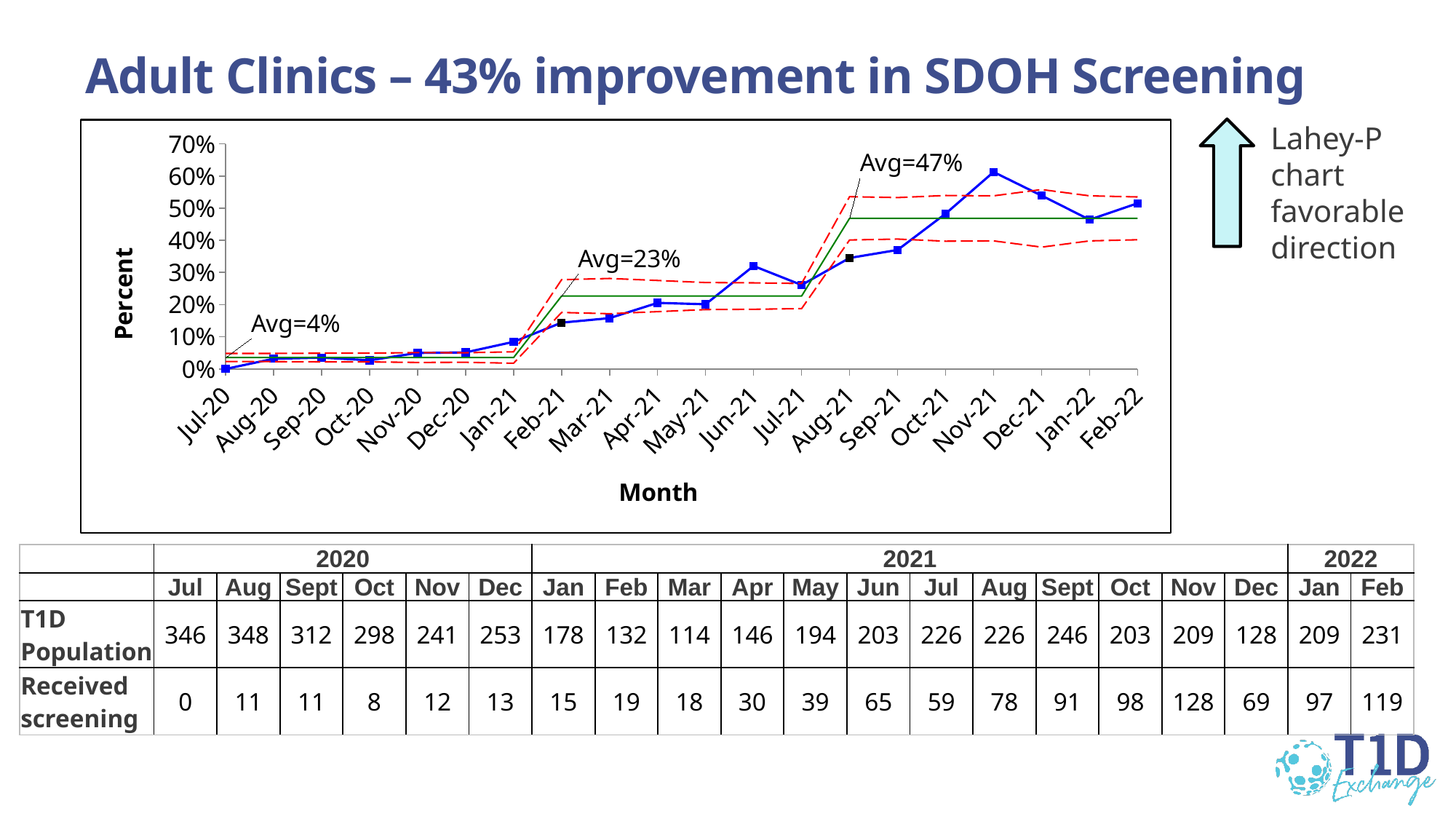
Is the value for Nov-21 greater or less than 60%? greater What is the average percentage shown for the middle phase of the chart (starting Feb-21)? Avg=23% Do the plotted values generally rise or fall from Jul-20 to Feb-22? rise What is the label on the y axis of the chart? Percent What kind of chart is shown on the slide? line chart What is the average percentage shown for the final phase of the chart (starting Aug-21)? Avg=47% What is the average percentage shown for the first phase of the chart (starting Jul-20)? Avg=4% Which month has the lowest screening percentage on the chart? Jul-20 Which month has a higher value on the chart, Jun-21 or Jul-21? Jun-21 Is the value for Jul-21 greater or less than 30%? less How many months are plotted along the x axis of the chart? 20 Which month has the highest screening percentage on the chart? Nov-21